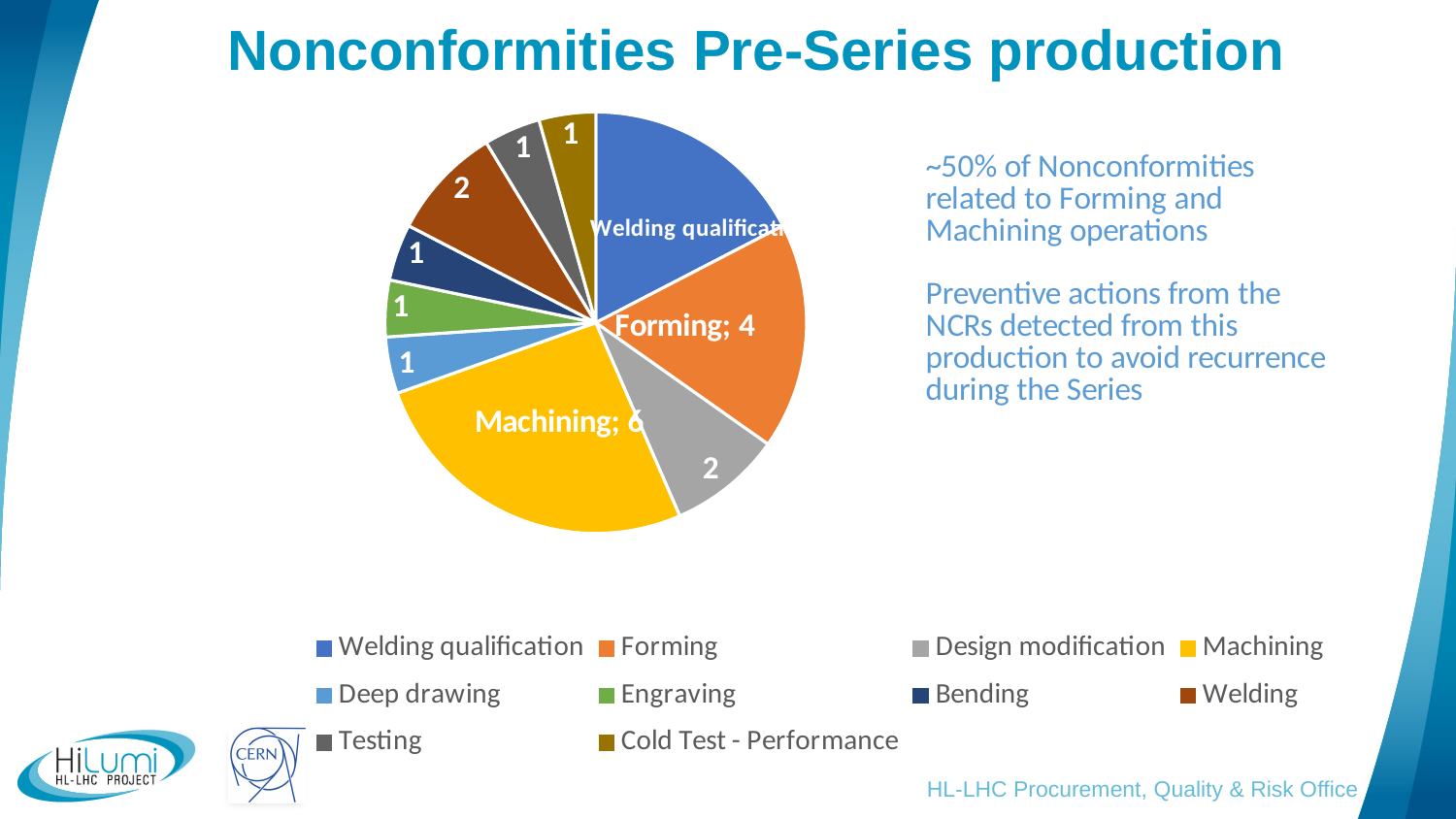
Which category has the largest slice in the pie chart? Machining What is the value for Machining in the pie chart? 6 How many categories does the legend of the pie chart list? 10 What is the difference between the values for Machining and Forming? 2 What kind of chart is shown on the slide? Pie chart What is the value for Forming in the pie chart? 4 Which is larger, the value for Welding or the value for Bending? Welding What is the value for Design modification in the pie chart? 2 What is the value for Bending in the pie chart? 1 Which is larger, the value for Forming or the value for Machining? Machining What is the value for Welding in the pie chart? 2 What is the title of the slide containing the chart? Nonconformities Pre-Series production